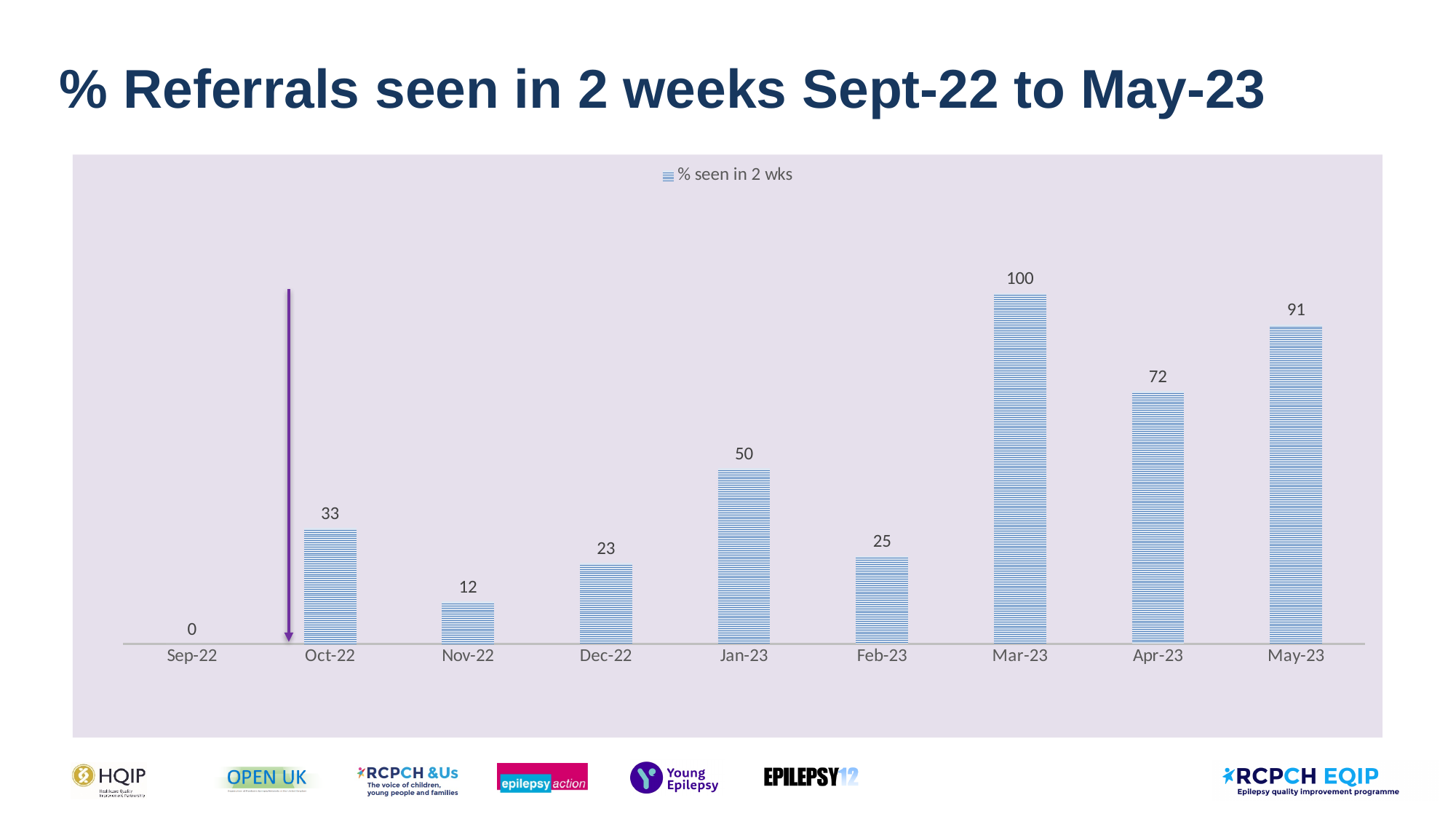
What is the value for Jan-23? 50 What is the difference between the values for Mar-23 and Apr-23? 28 What is the legend entry for the series? % seen in 2 wks How many months are shown on the x axis? 9 Which month has the highest value? Mar-23 What is the difference between the values for Oct-22 and Nov-22? 21 What is the value for Nov-22? 12 How many series does the legend list? 1 Which month has the lowest value? Sep-22 Which is larger, the value for Dec-22 or the value for Feb-23? Feb-23 What kind of chart is shown? Bar chart What is the value for Apr-23? 72